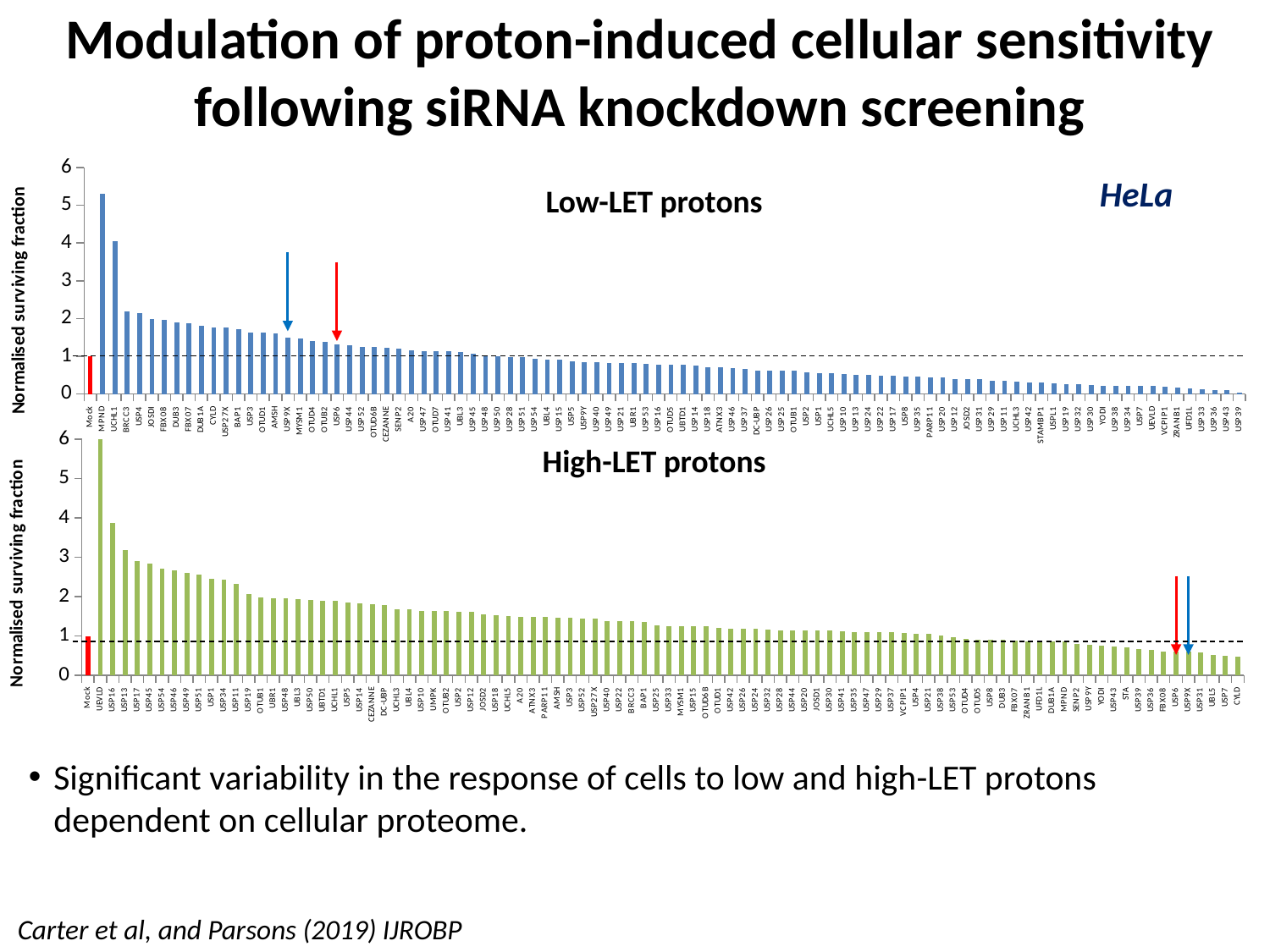
In the High-LET protons chart, do the values generally rise or fall from left to right along the x axis? fall In the High-LET protons chart, which is larger, the value for UEVLD or the value for USP16? UEVLD In the High-LET protons chart, which category has the highest normalised surviving fraction? UEVLD What is the y-axis label of the Low-LET protons chart? Normalised surviving fraction In the High-LET protons chart, is the value for CYLD greater or less than 1? less In the High-LET protons chart, is the value for UEVLD greater or less than 5? greater In the High-LET protons chart, is the value for USP16 greater or less than 3? greater What colour are the bars in the High-LET protons chart (excluding Mock)? green In the Low-LET protons chart, which is larger, the value for MPND or the value for UCHL1? MPND What type of chart is the Low-LET protons chart? bar chart In the Low-LET protons chart, which category has the highest normalised surviving fraction? MPND